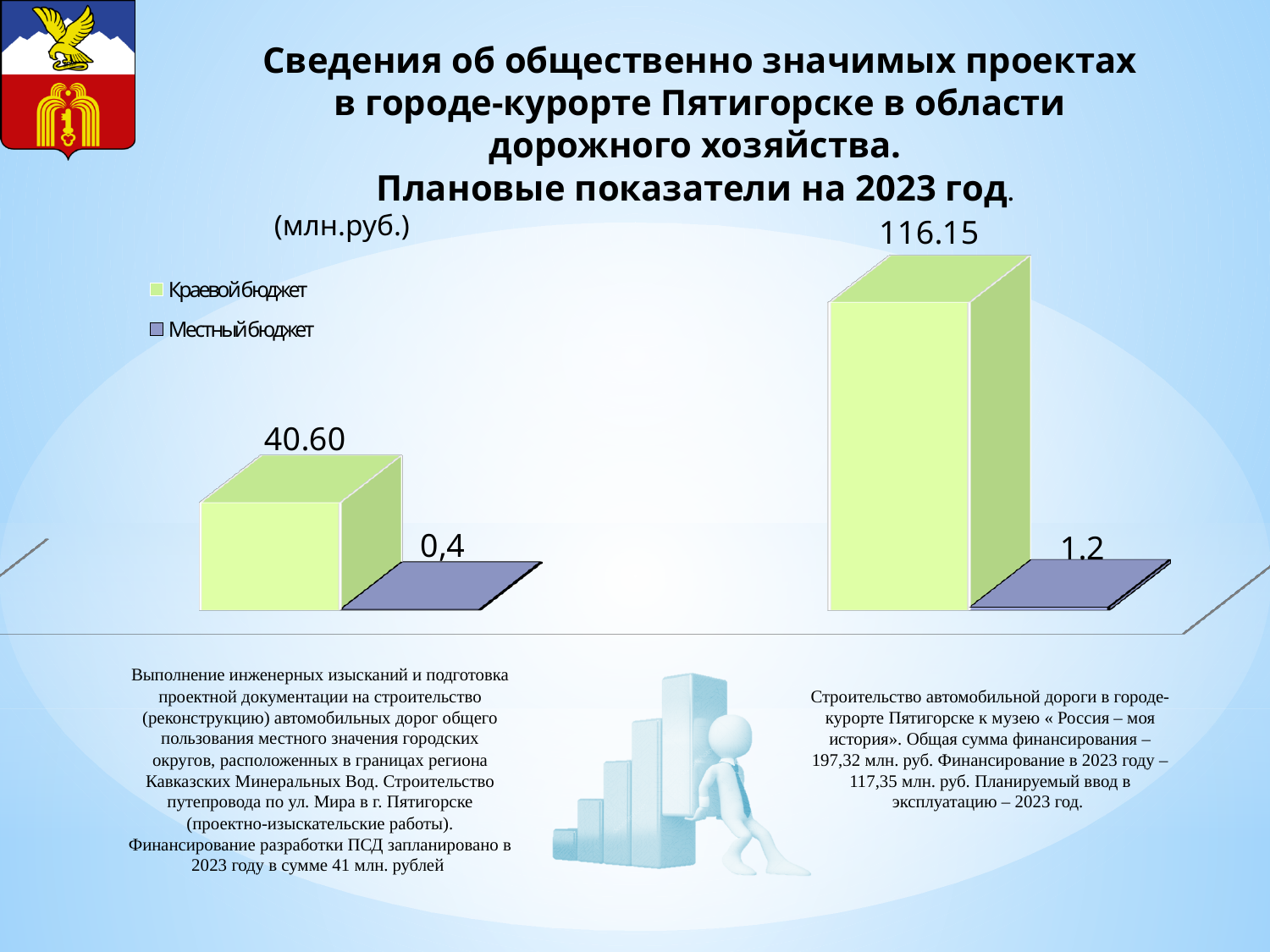
What kind of chart is shown on the slide? bar chart Which is larger: the Краевой бюджет value in the left group or in the right group? right group What unit is indicated for the chart values? млн.руб. What is the value of the Краевой бюджет bar in the left group of the chart? 40.60 What is the value of the Краевой бюджет bar in the right group of the chart? 116.15 Which bar in the chart has the highest value? Краевой бюджет in the right group (116.15) What are the two series named in the chart legend? Краевой бюджет and Местный бюджет How many series does the chart legend list? 2 What is the value of the Местный бюджет bar in the right group of the chart? 1.2 What is the difference between the Краевой бюджет values of the right group and the left group? 75.55 What is the value of the Местный бюджет bar in the left group of the chart? 0,4 Which bar in the chart has the lowest value? Местный бюджет in the left group (0,4)